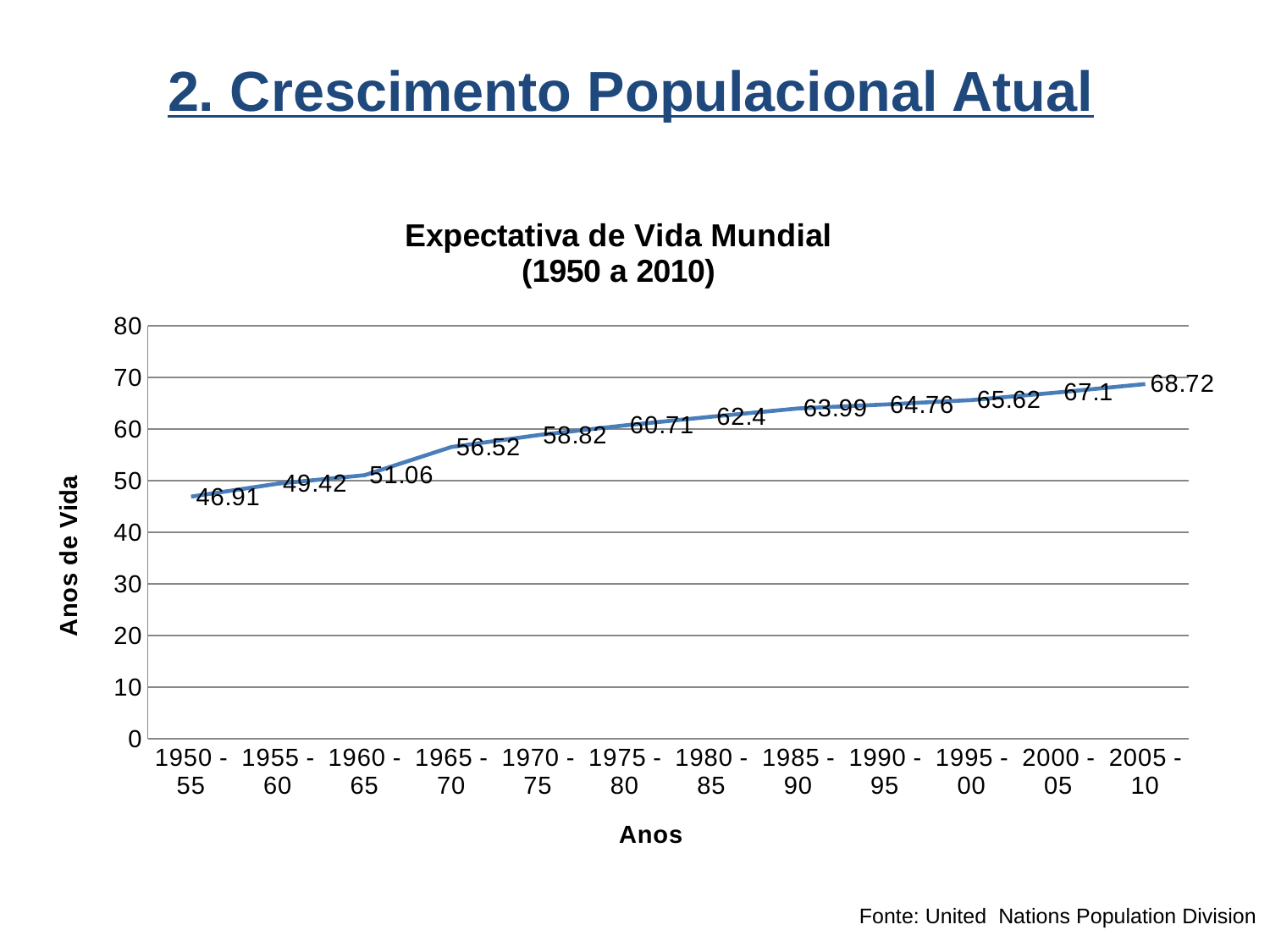
Which period has the lowest life expectancy value? 1950 - 55 What is the difference between the values for 1965 - 70 and 1960 - 65? 5.46 What kind of chart is shown on the slide? line chart What is the difference between the values for 2005 - 10 and 1950 - 55? 21.81 What is the value plotted for 2005 - 10? 68.72 Which is larger, the value for 1985 - 90 or the value for 1980 - 85? 1985 - 90 What is the world life expectancy value for 1950 - 55? 46.91 What is the value for 1975 - 80? 60.71 Do the values rise or fall from 1950 - 55 to 2005 - 10? rise Is the value for 1990 - 95 greater or less than 60? greater How many periods are plotted on the x axis? 12 Which period has the highest life expectancy value? 2005 - 10